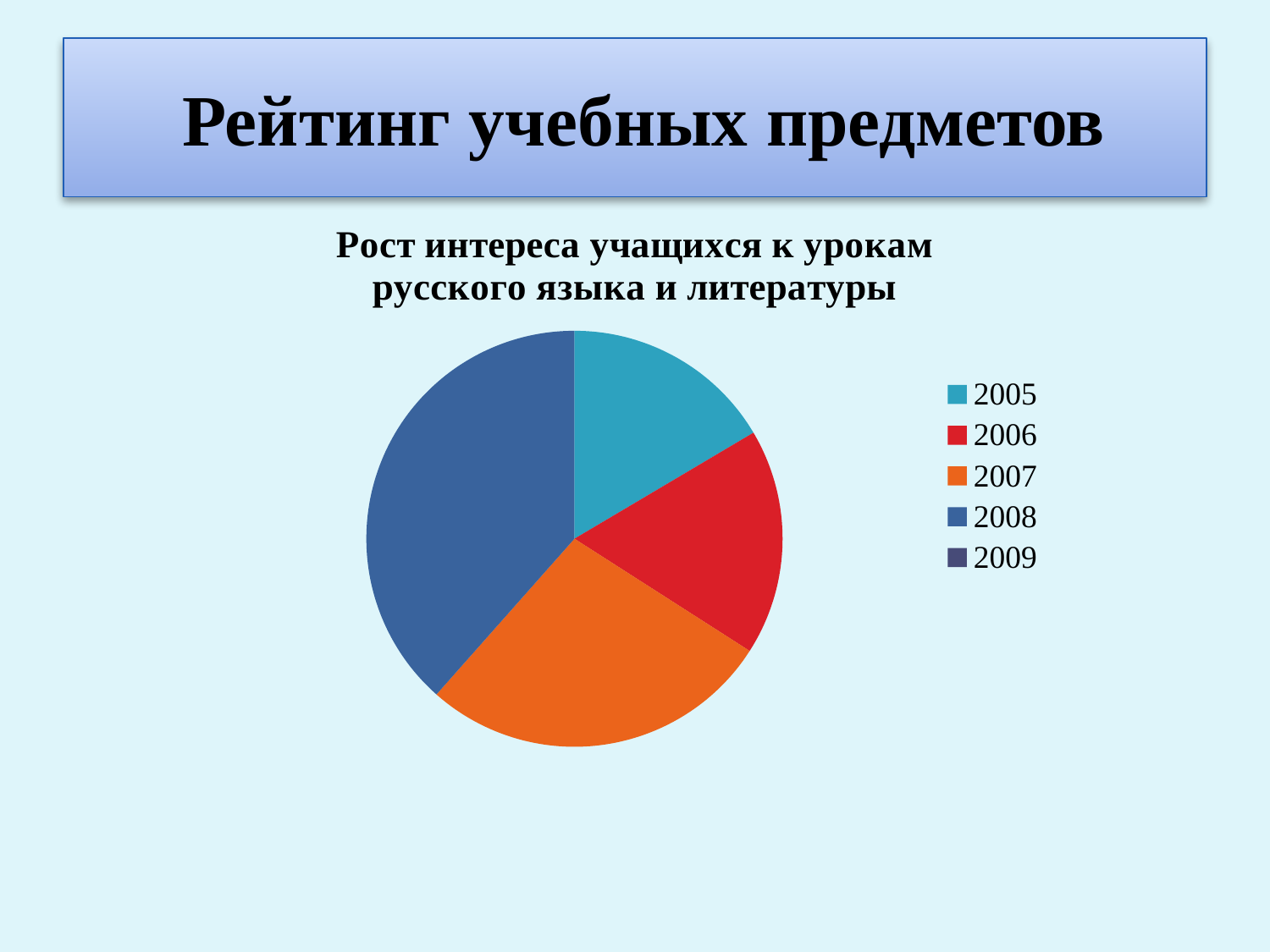
What is the last year listed in the legend? 2009 Which slice is larger, 2007 or 2006? 2007 What is the title of the chart? Рост интереса учащихся к урокам русского языка и литературы Which year is shown in orange in the legend? 2007 Which slice is larger, 2007 or 2005? 2007 Which slice is larger, 2008 or 2005? 2008 What kind of chart is shown on the slide? pie chart Which year has the largest slice of the pie? 2008 How many entries does the chart's legend list? 5